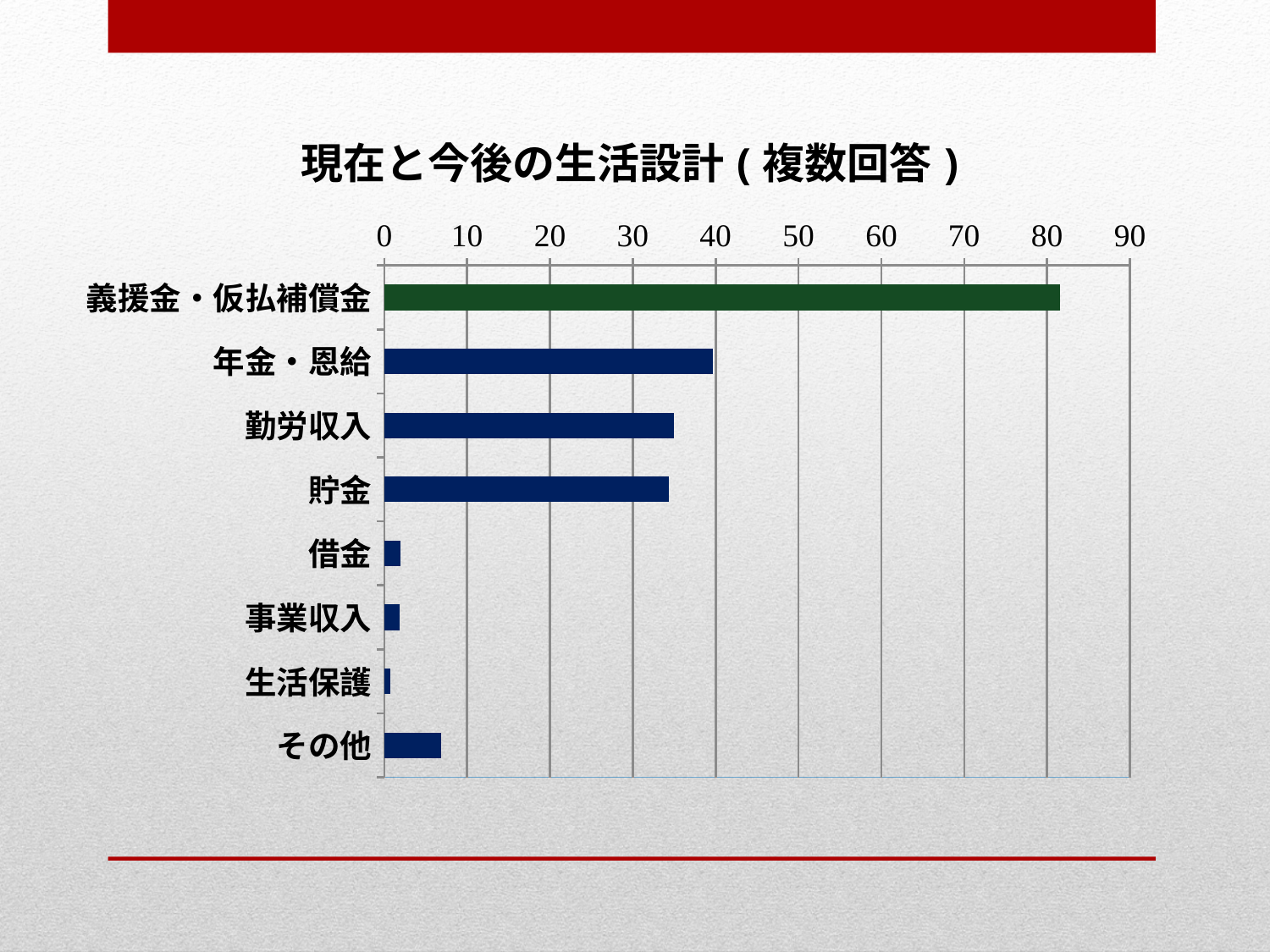
Is the value for その他 greater or less than 10? less What is the title of the chart? 現在と今後の生活設計 ( 複数回答 ) What kind of chart is shown on the slide? bar chart Which is larger, the value for その他 or the value for 借金? その他 Is the value for 勤労収入 greater or less than 30? greater How many categories are plotted in the chart? 8 Which category has the highest value? 義援金・仮払補償金 Which category has the lowest value? 生活保護 Is the value for 義援金・仮払補償金 greater or less than 80? greater Which category's bar is coloured green rather than dark blue? 義援金・仮払補償金 Which is larger, the value for 年金・恩給 or the value for 勤労収入? 年金・恩給